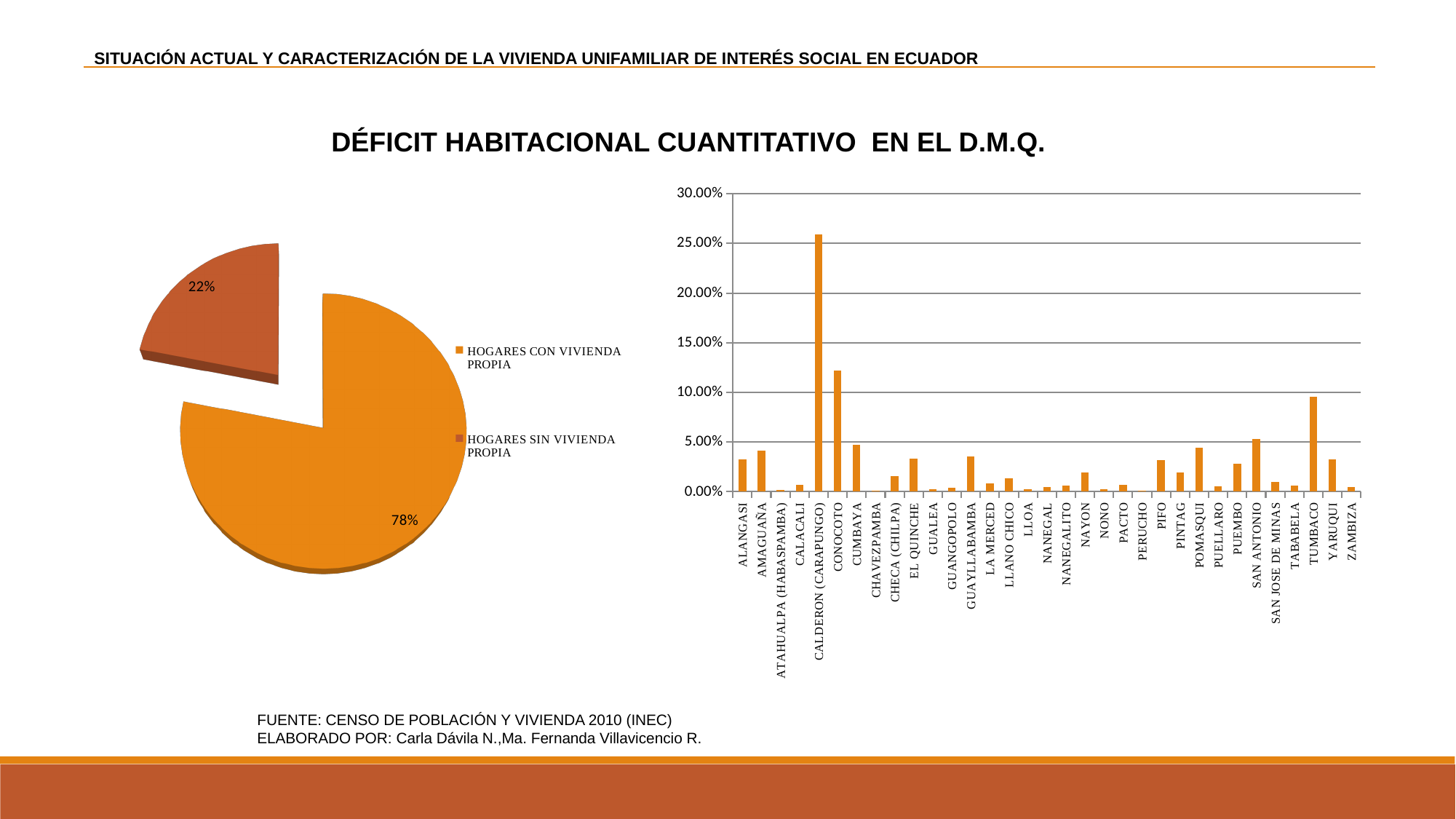
What kind of chart is the chart on the left of the slide? Pie chart In the pie chart on the left, what share is shown for HOGARES CON VIVIENDA PROPIA? 78% In the pie chart on the left, how many categories does the legend list? 2 In the bar chart on the right, which parish has the highest value? CALDERON (CARAPUNGO) In the bar chart on the right, which has the larger value, CONOCOTO or CUMBAYA? CONOCOTO In the pie chart on the left, which category has the larger slice? HOGARES CON VIVIENDA PROPIA In the pie chart on the left, what share is shown for HOGARES SIN VIVIENDA PROPIA? 22% In the bar chart on the right, is the value for TUMBACO greater or less than 5.00%? greater In the bar chart on the right, is the value for CONOCOTO greater or less than 10.00%? greater In the bar chart on the right, is the value for CALDERON (CARAPUNGO) greater or less than 20.00%? greater How many parishes are shown on the x axis of the bar chart on the right? 33 What kind of chart is the chart on the right of the slide? Bar chart